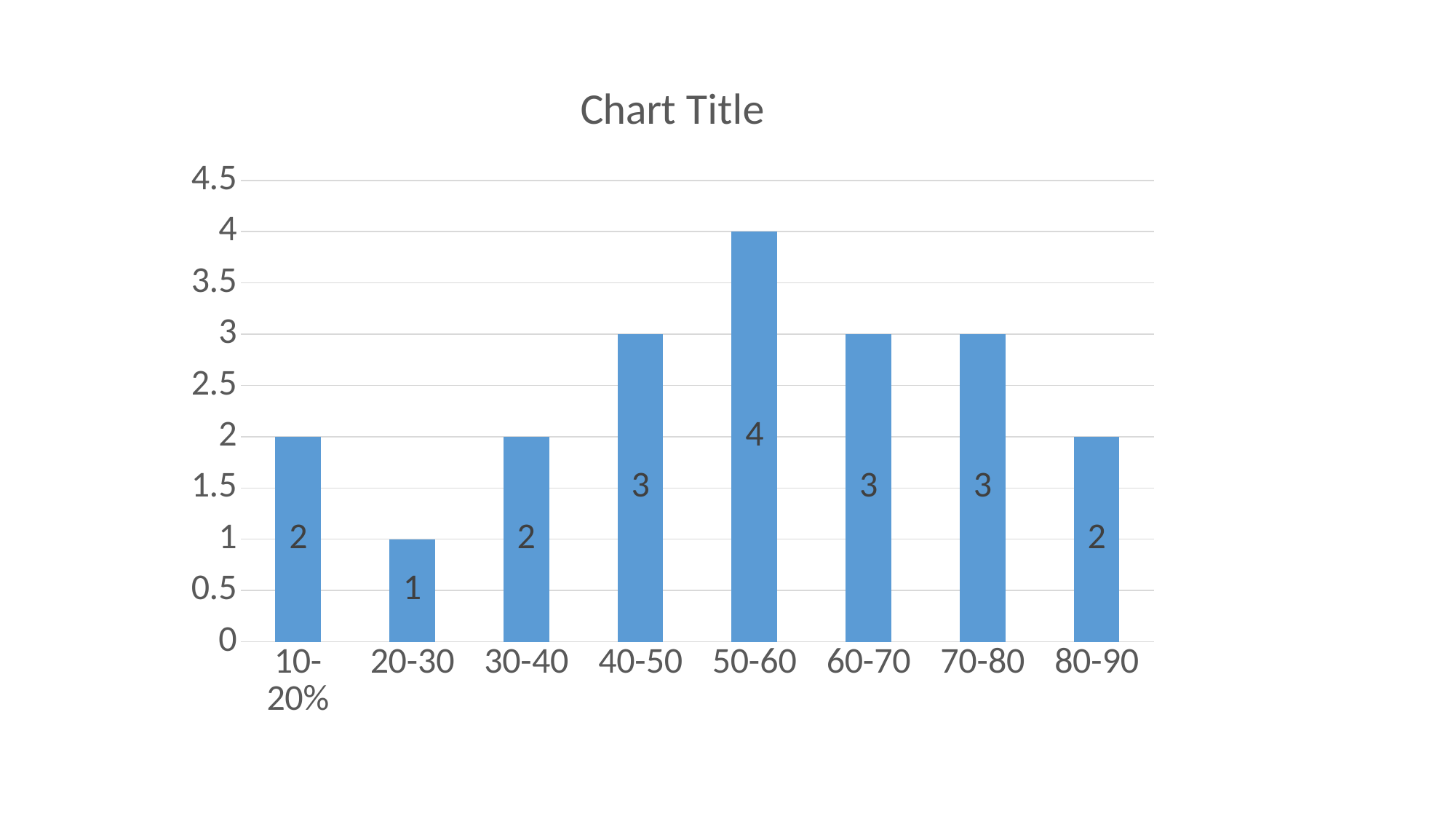
How many categories are shown on the x axis? 8 Which category has the lowest value? 20-30 Which is larger, the value for 40-50 or the value for 30-40? 40-50 What is the title of the chart? Chart Title What is the difference between the values for 60-70 and 10-20%? 1 What kind of chart is this? bar chart What is the value for the 20-30 category? 1 What is the difference between the values for 50-60 and 20-30? 3 Which category has the highest value? 50-60 What is the value for the 80-90 category? 2 What is the value for the 50-60 category? 4 Is the value for 50-60 greater or less than 3.5? greater